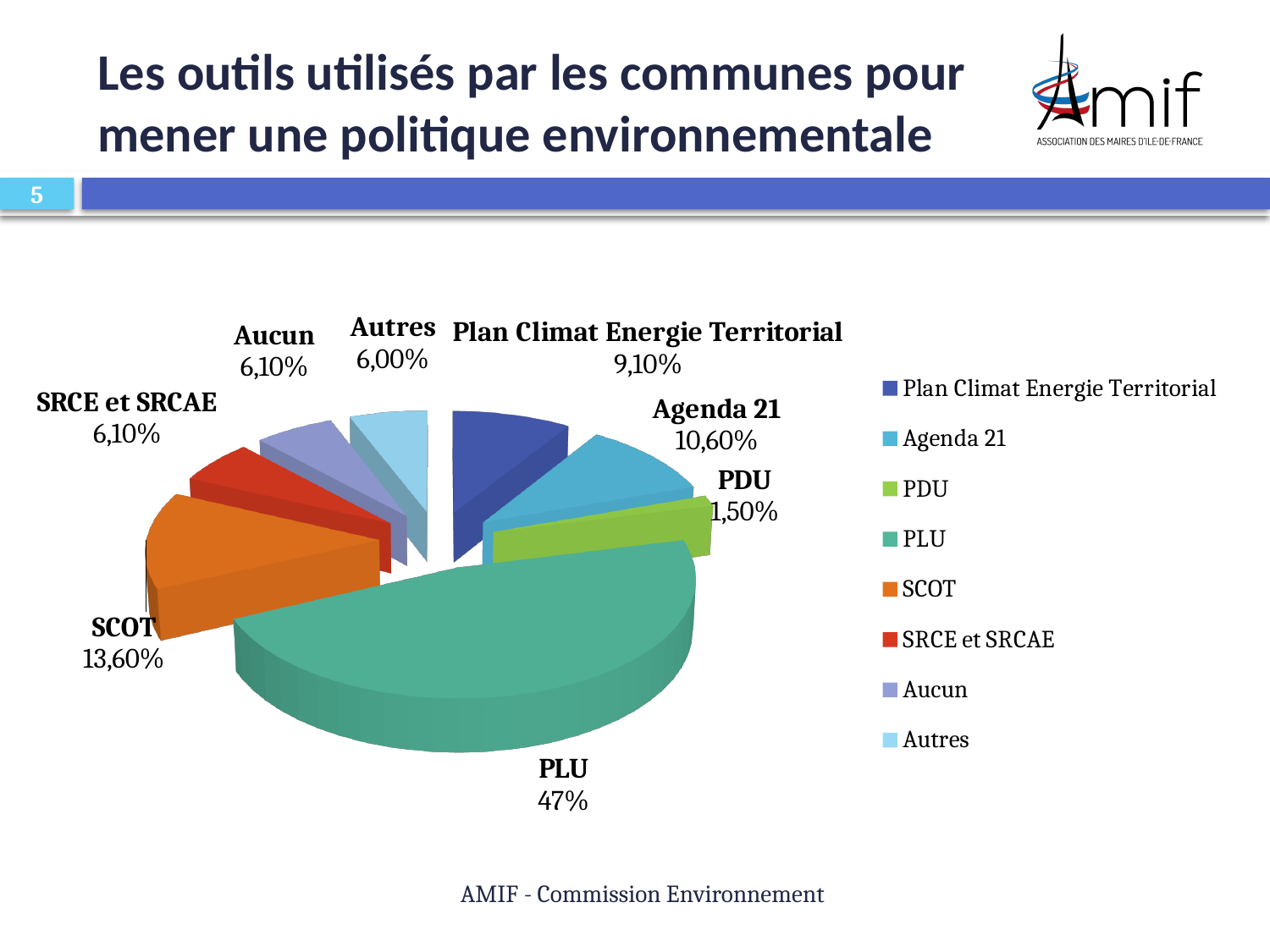
Which category has the smallest share of the pie? PDU What is the difference between the values for PLU and SCOT? 33,40% What is the value for Agenda 21? 10,60% What is the value for PLU? 47% Which category has the largest share of the pie? PLU How many categories does the pie chart have? 8 What is the value for PDU? 1,50% Which is larger, the value for Agenda 21 or the value for Plan Climat Energie Territorial? Agenda 21 What kind of chart is shown on the slide? pie chart Which colour represents SCOT in the legend? orange What is the value for SCOT? 13,60% What is the value for Plan Climat Energie Territorial? 9,10%